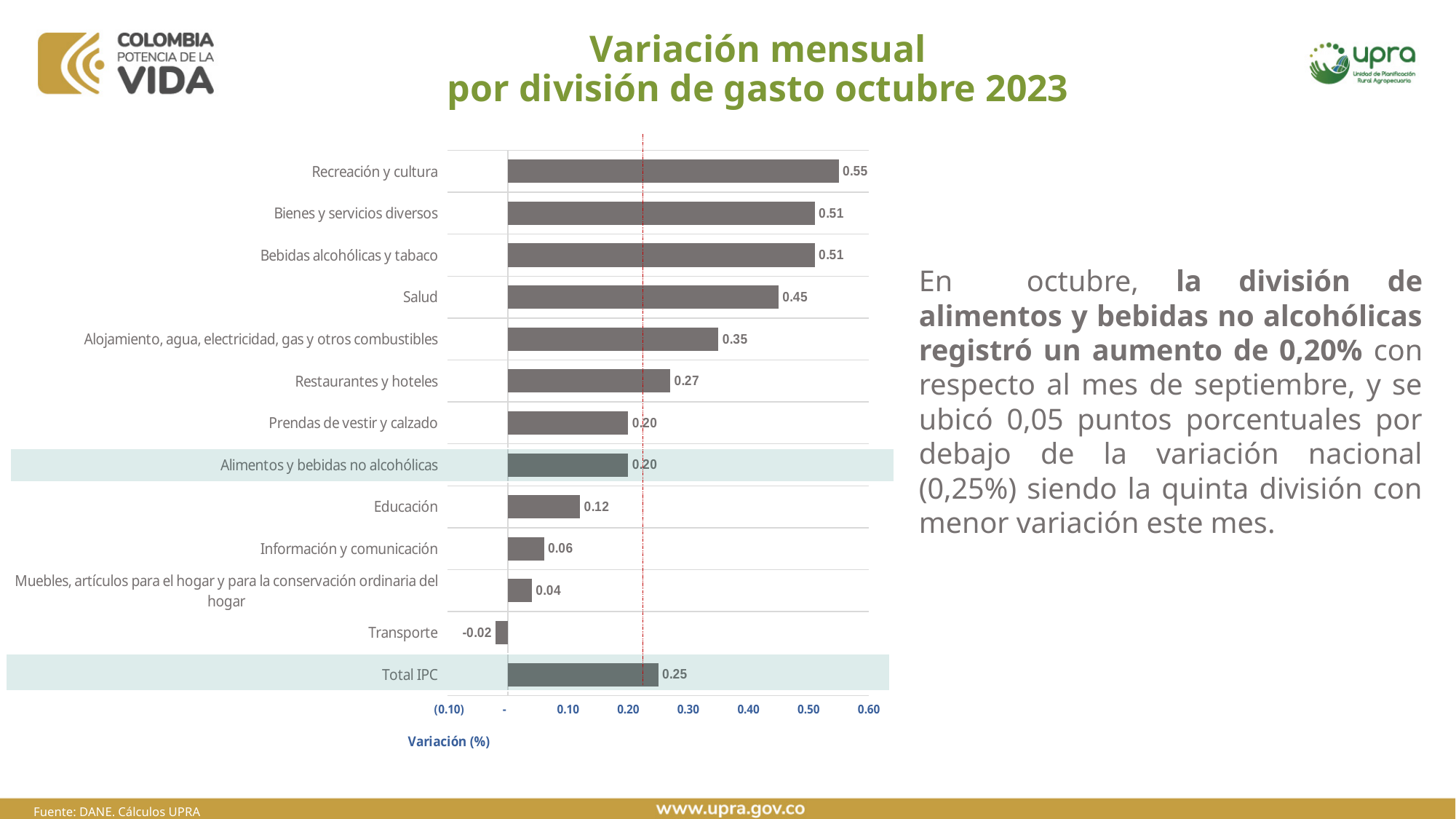
What is the value for Total IPC? 0.25 What kind of chart is shown on the slide? Bar chart What is the value for Transporte? -0.02 What is the label of the horizontal axis? Variación (%) What is the value for Alimentos y bebidas no alcohólicas? 0.20 What is the value for Recreación y cultura? 0.55 Which category has the highest value? Recreación y cultura Which category has the lowest value? Transporte What is the title of the chart? Variación mensual por división de gasto octubre 2023 How many categories are shown in the chart? 13 Which is larger, the value for Restaurantes y hoteles or the value for Educación? Restaurantes y hoteles What is the difference between the values for Recreación y cultura and Salud? 0.10